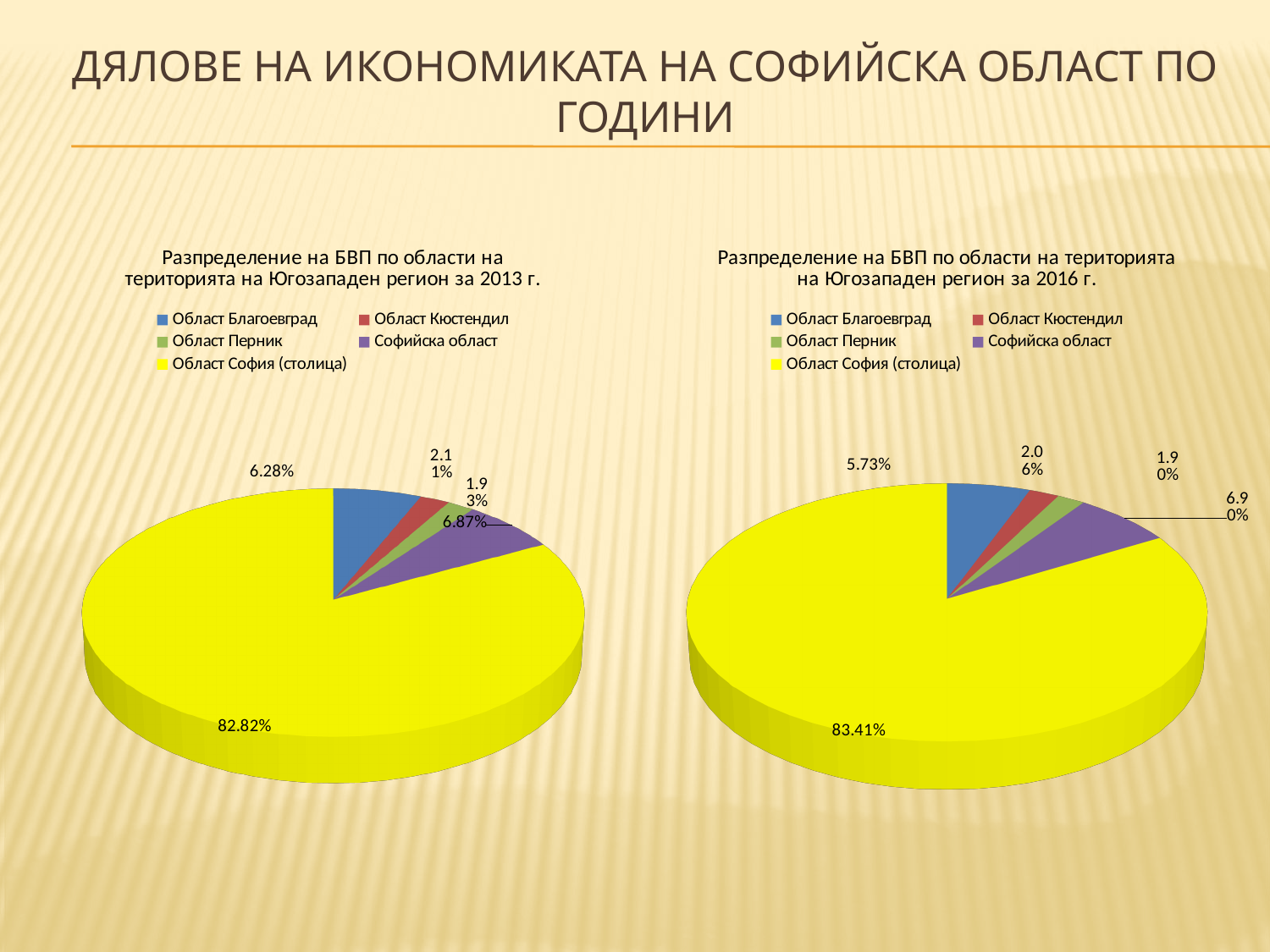
In the left chart (2013), what is the value for Област Благоевград? 6.28% How many entries does the legend of the left chart (2013) list? 5 In the right chart (2016), which region has the smallest share? Област Перник What type of chart is used on this slide? Pie chart In the right chart (2016), what share of GDP does Област София (столица) have? 83.41% In the left chart (2013), what share of GDP does Област София (столица) have? 82.82% In the left chart (2013), what is the value for Софийска област? 6.87% In the left chart (2013), which region has the largest share? Област София (столица) How many slices does the right chart (2016) have? 5 In the right chart (2016), what is the value for Област Благоевград? 5.73% In the left chart (2013), what is the difference between the share of Област София (столица) and the share of Софийска област? 75.95% In the left chart (2013), which is larger: the share of Софийска област or the share of Област Благоевград? Софийска област